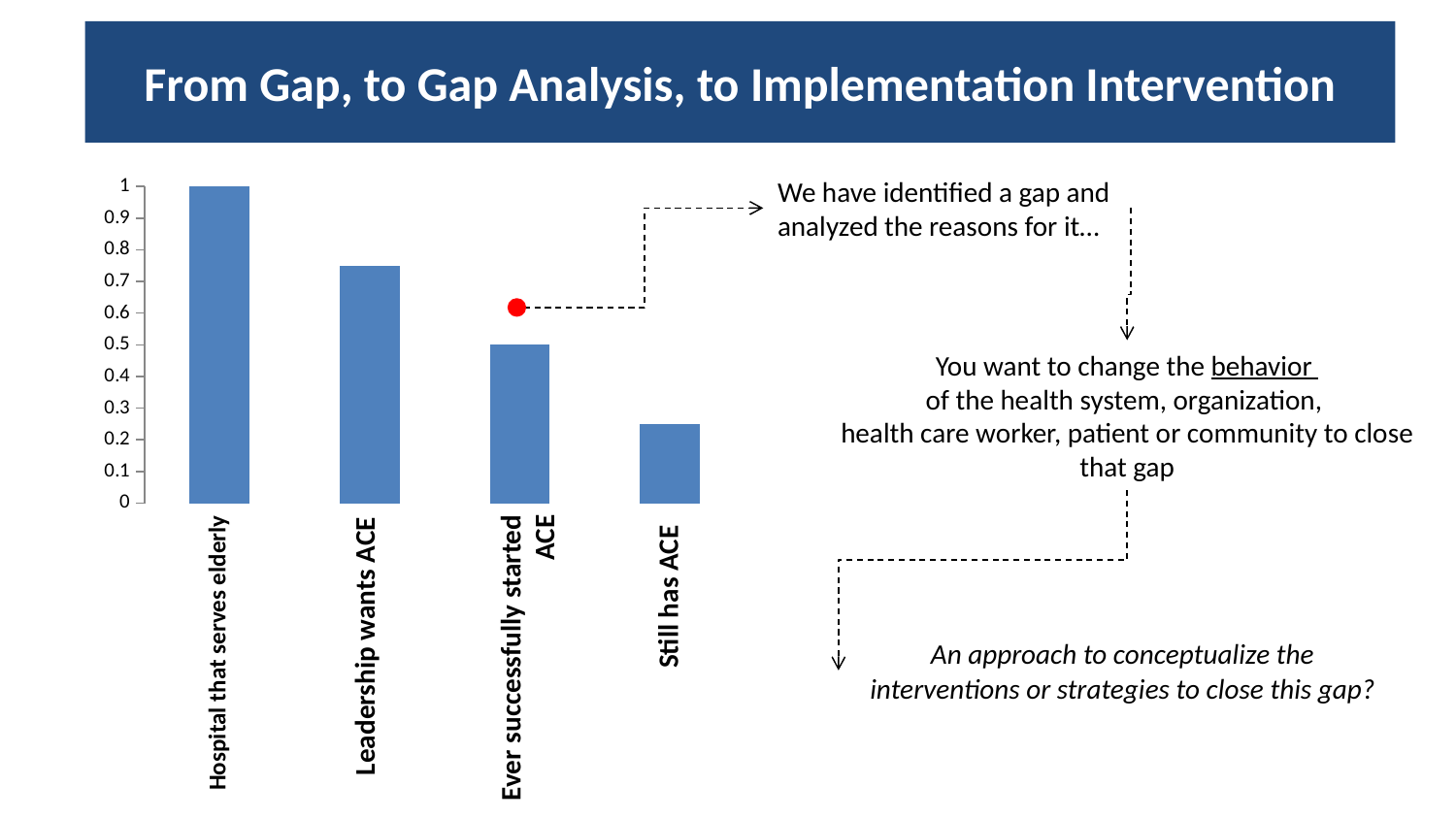
Is the value for "Leadership wants ACE" greater or less than 0.7? greater Do the bar values rise or fall from left to right along the x axis? fall What is the difference between the values for "Hospital that serves elderly" and "Ever successfully started ACE"? 0.5 What is the value for "Hospital that serves elderly"? 1 Above which bar is the red dot placed? Ever successfully started ACE What is the value for "Ever successfully started ACE"? 0.5 Is the value for "Still has ACE" greater or less than 0.3? less How many categories are plotted in the bar chart? 4 Which category has the lowest value? Still has ACE Which category has the highest value? Hospital that serves elderly What kind of chart is shown on the slide? bar chart Which is larger, the value for "Leadership wants ACE" or the value for "Still has ACE"? Leadership wants ACE